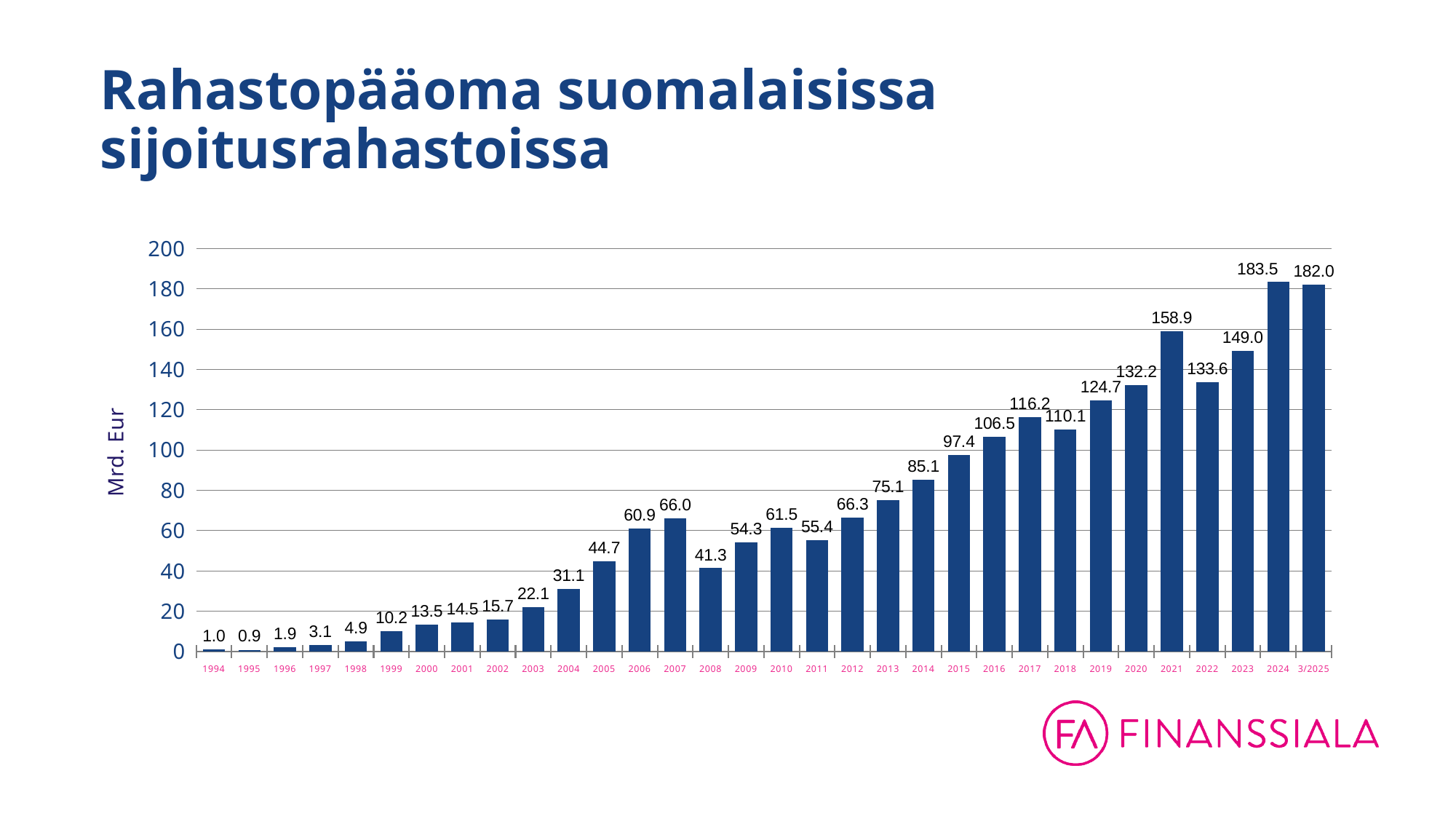
How many bars are shown in the chart? 32 Is the value for 2019 greater or less than 120? greater What kind of chart is shown on the slide? bar chart What is the difference between the values for 2021 and 2022? 25.3 What is the difference between the values for 2024 and 2023? 34.5 What is the label of the vertical axis? Mrd. Eur What is the value for 2024? 183.5 Which year has the highest value? 2024 What is the value for 3/2025? 182.0 Which year has the lowest value? 1995 Which is larger, the value for 2007 or the value for 2010? 2007 What is the value for 2008? 41.3